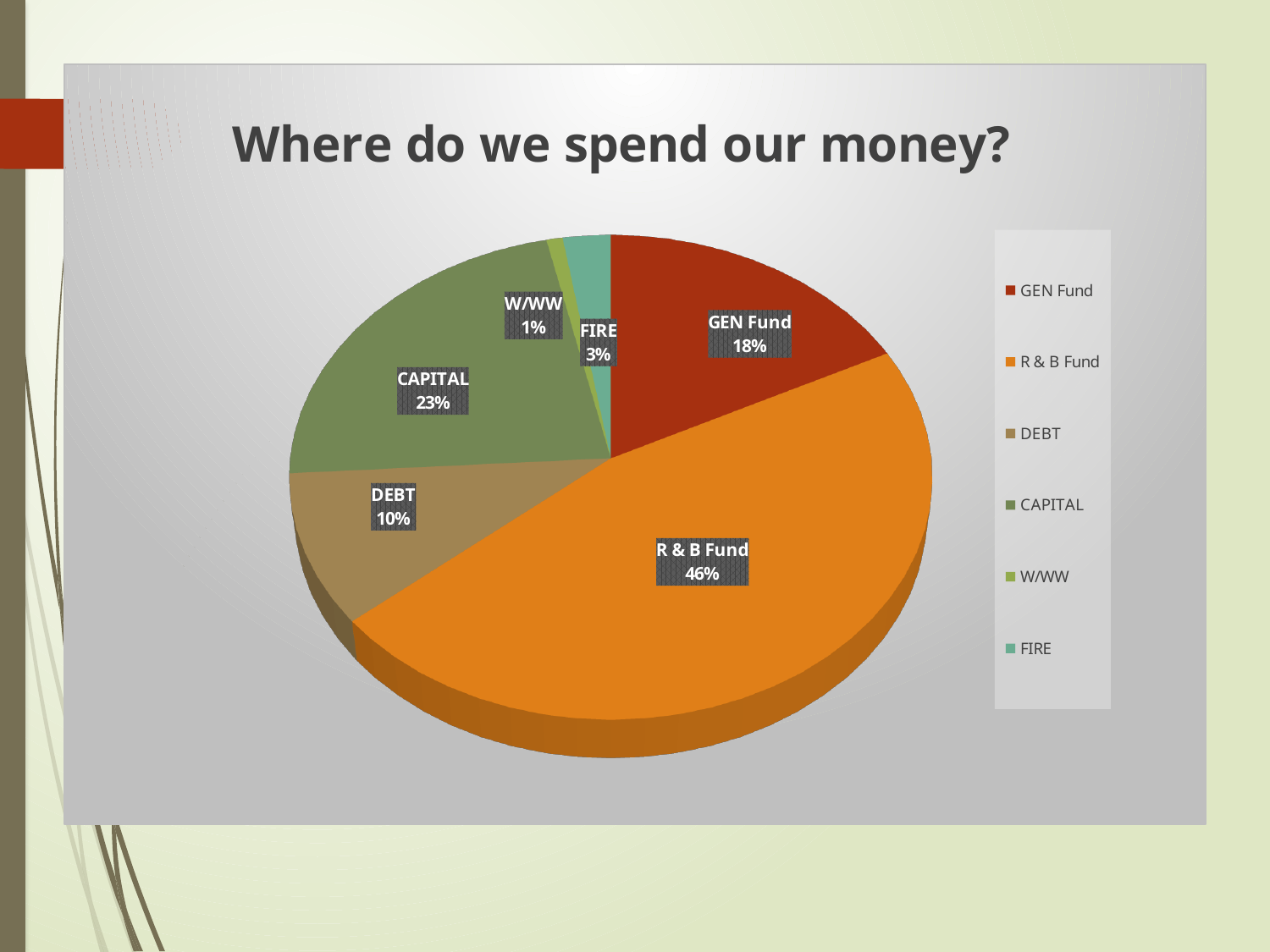
What percentage is shown for the GEN Fund slice? 18% Which is larger, the DEBT slice or the FIRE slice? DEBT How many categories are shown in the pie chart? 6 What is the title of the slide containing the chart? Where do we spend our money? What is the difference in percentage points between CAPITAL and GEN Fund? 5 Which category has the smallest slice of the pie? W/WW What percentage is shown for FIRE? 3% What type of chart is shown on the slide? Pie chart What percentage is shown for CAPITAL? 23% What share of spending goes to the R & B Fund? 46% Which category has the largest slice of the pie? R & B Fund What percentage is shown for DEBT? 10%